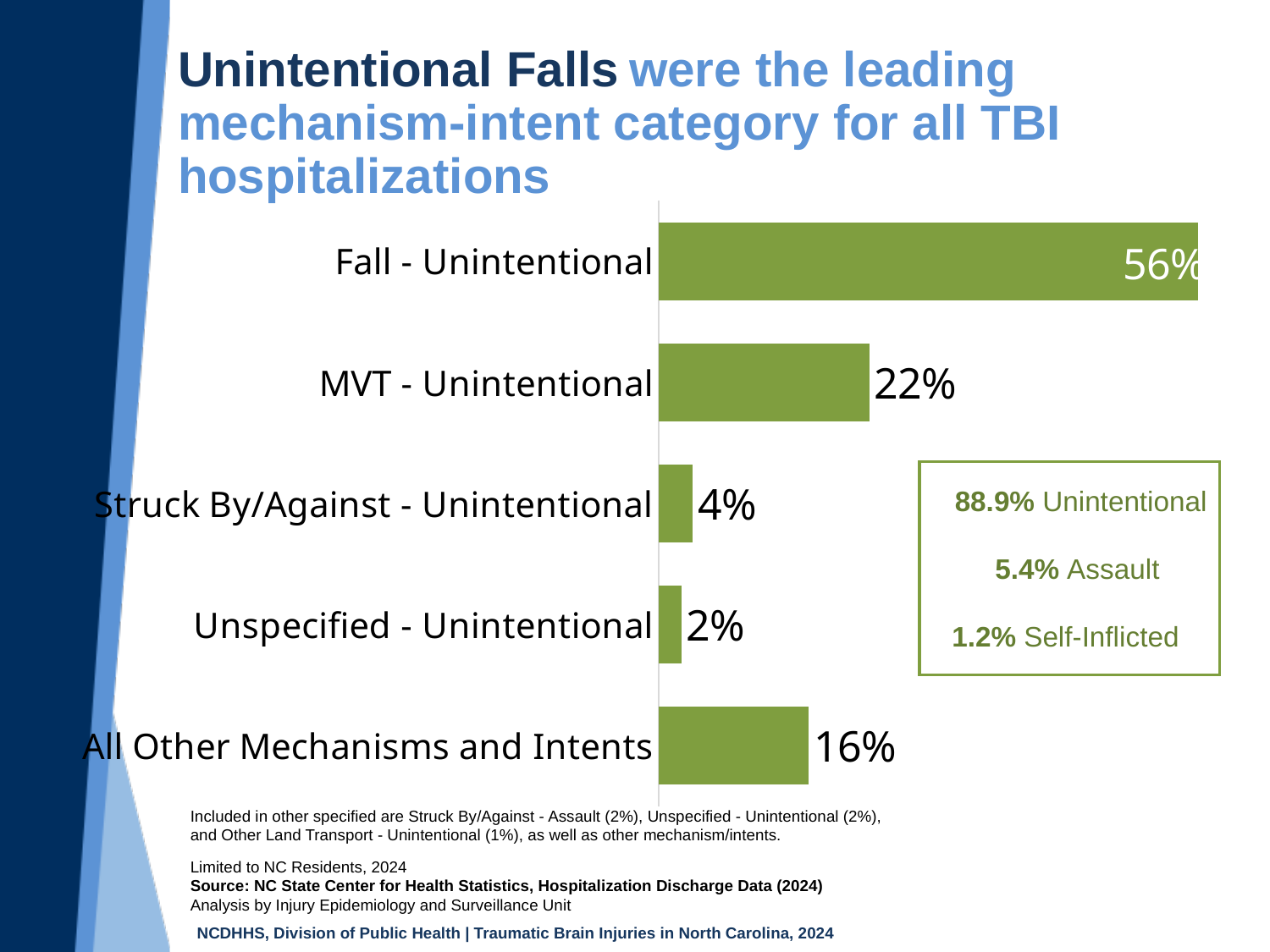
What is the value for MVT - Unintentional? 22% What is the value for Struck By/Against - Unintentional? 4% What percentage of TBI hospitalizations is shown for Fall - Unintentional? 56% What is the difference between Fall - Unintentional and MVT - Unintentional? 34% Which category has the highest value? Fall - Unintentional Which is larger, MVT - Unintentional or All Other Mechanisms and Intents? MVT - Unintentional What is the difference between Struck By/Against - Unintentional and Unspecified - Unintentional? 2% How many categories are plotted in the chart? 5 What kind of chart is shown on the slide? Bar chart According to the box beside the chart, what percentage of TBI hospitalizations were Assault? 5.4% What is the value for All Other Mechanisms and Intents? 16% Which category has the lowest value? Unspecified - Unintentional